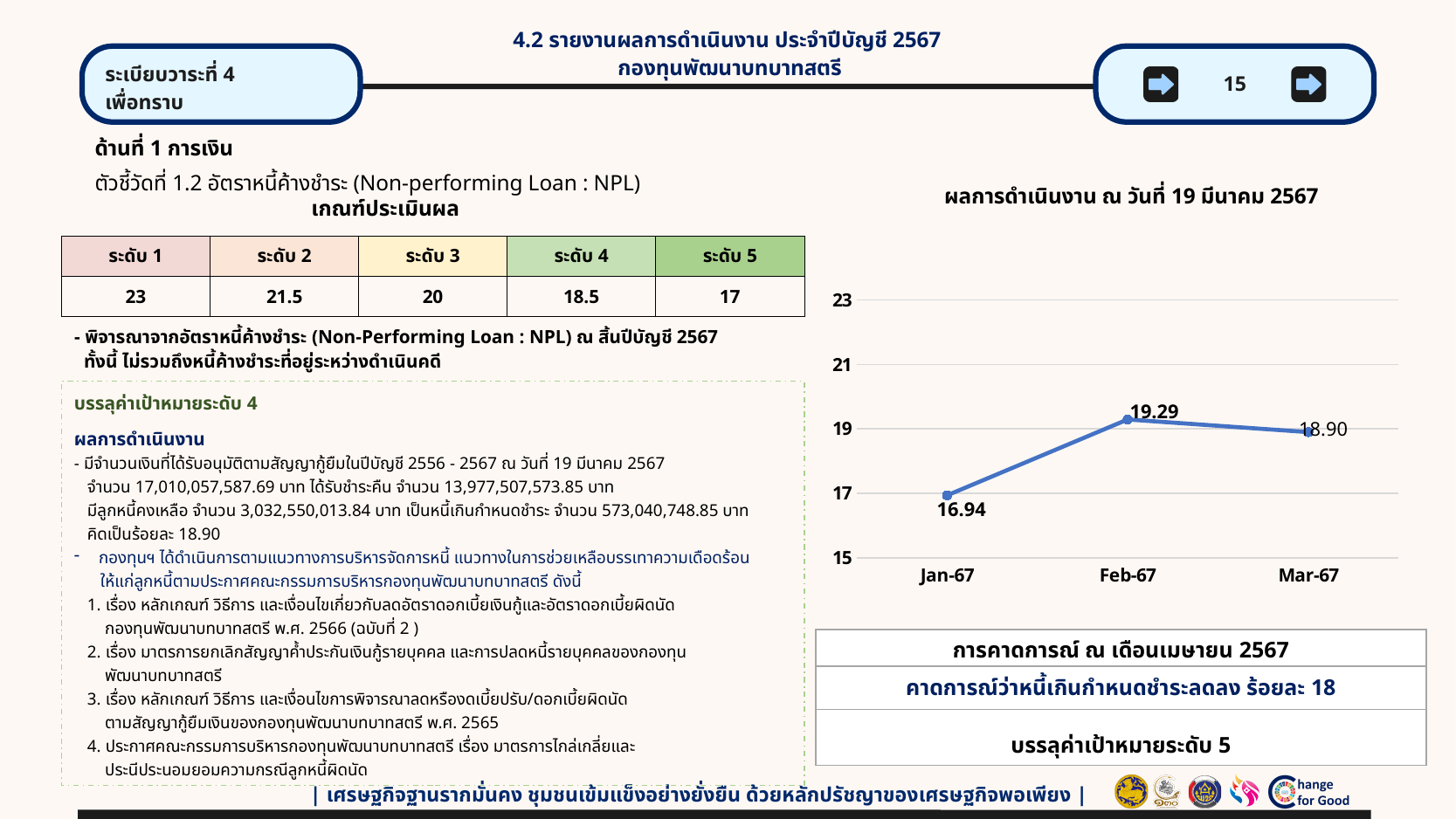
What is the value for Jan-67? 16.94 Which month has the highest value? Feb-67 How many data points are plotted on the chart? 3 What is the difference between the values for Feb-67 and Mar-67? 0.39 Does the value rise or fall from Feb-67 to Mar-67? fall Which is larger, the value for Mar-67 or the value for Jan-67? Mar-67 What type of chart is shown on the slide? line chart Which month has the lowest value? Jan-67 Is the value for Jan-67 greater or less than 17? less What is the value for Feb-67? 19.29 What is the difference between the values for Feb-67 and Jan-67? 2.35 What is the value for Mar-67? 18.90